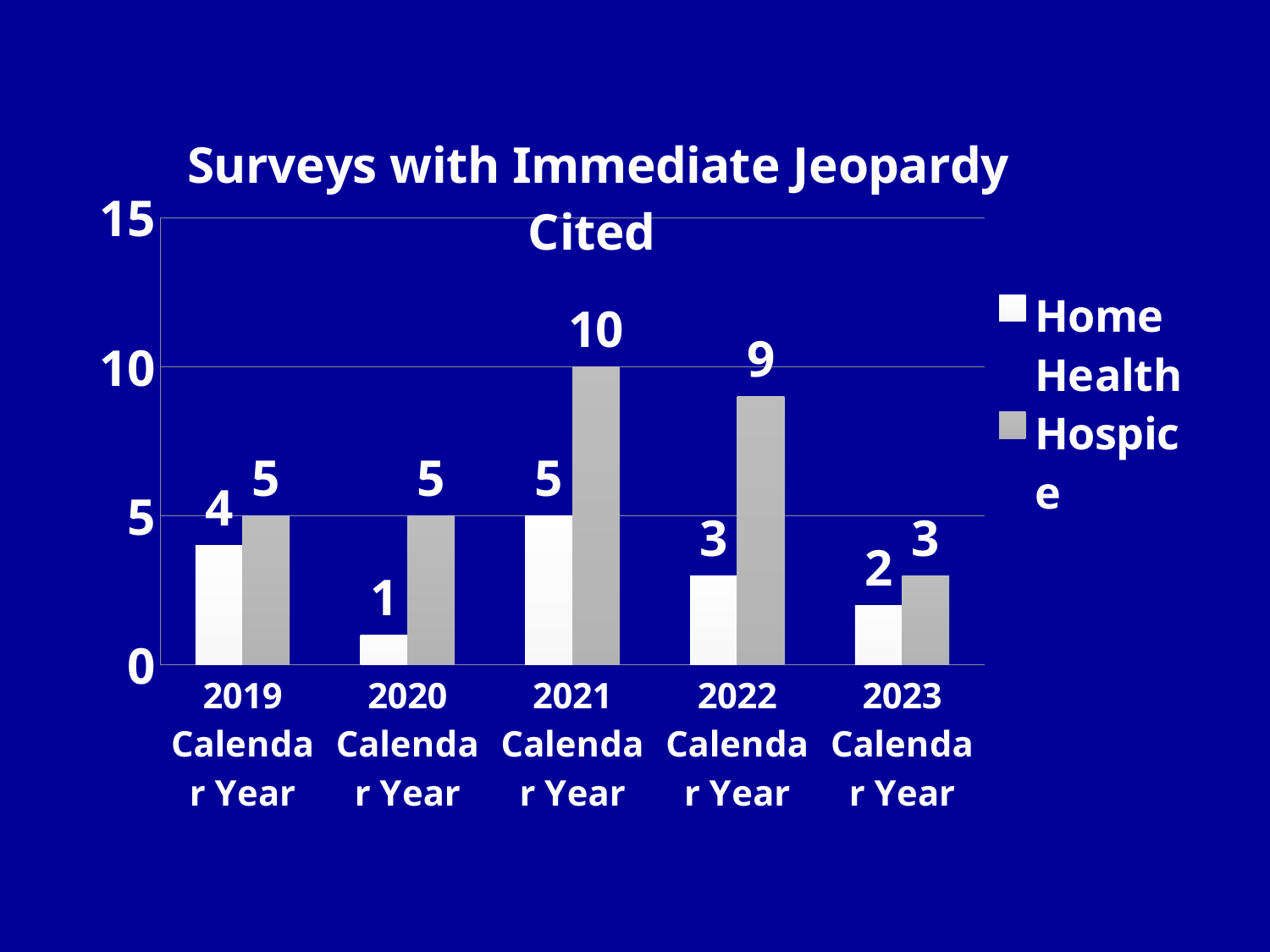
What is the Hospice value for 2021 Calendar Year? 10 Which calendar year has the highest Hospice value? 2021 Calendar Year How many series does the legend list? 2 Which calendar year has the lowest Home Health value? 2020 Calendar Year What is the Home Health value for 2020 Calendar Year? 1 What is the title of the chart? Surveys with Immediate Jeopardy Cited How many calendar years are shown on the x axis? 5 Is the Hospice value for 2022 Calendar Year greater or less than 5? greater What is the Home Health value for 2019 Calendar Year? 4 Which is larger for 2023 Calendar Year, Home Health or Hospice? Hospice What is the difference between the Hospice and Home Health values for 2022 Calendar Year? 6 What kind of chart is shown on the slide? bar chart